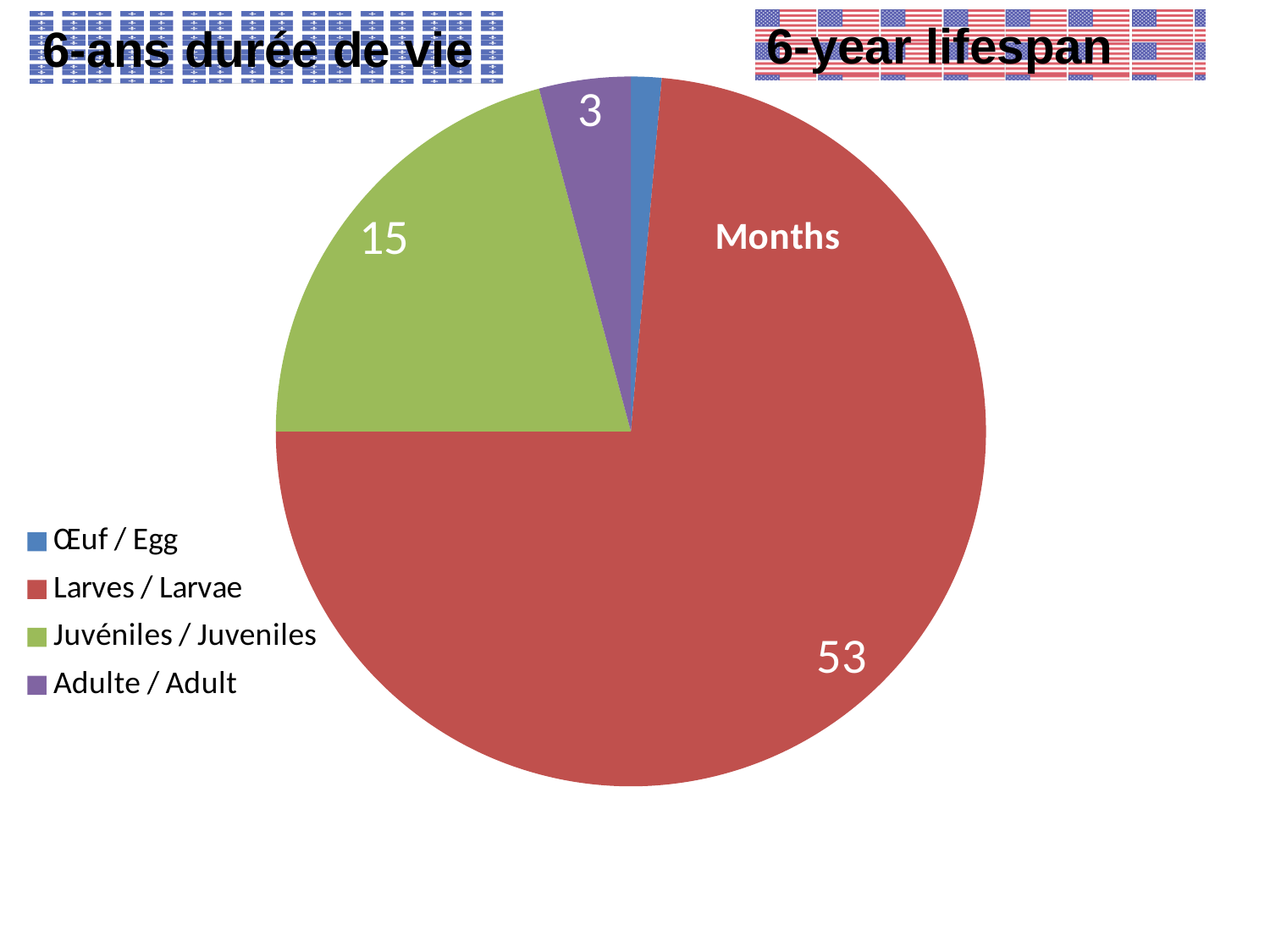
Which category has the smallest slice of the pie? Œuf / Egg What value is shown for the Juvéniles / Juveniles slice? 15 How many categories does the pie chart have? 4 What value is shown for the Adulte / Adult slice? 3 What is the difference between the Larves / Larvae value and the Juvéniles / Juveniles value? 38 Which category has the largest slice of the pie? Larves / Larvae What kind of chart is shown on the slide? Pie chart What value is shown for the Larves / Larvae slice? 53 What is the title of the chart? Months Which is larger, the Juvéniles / Juveniles slice or the Adulte / Adult slice? Juvéniles / Juveniles What is the difference between the Juvéniles / Juveniles value and the Adulte / Adult value? 12 What colour is the Larves / Larvae slice? Red